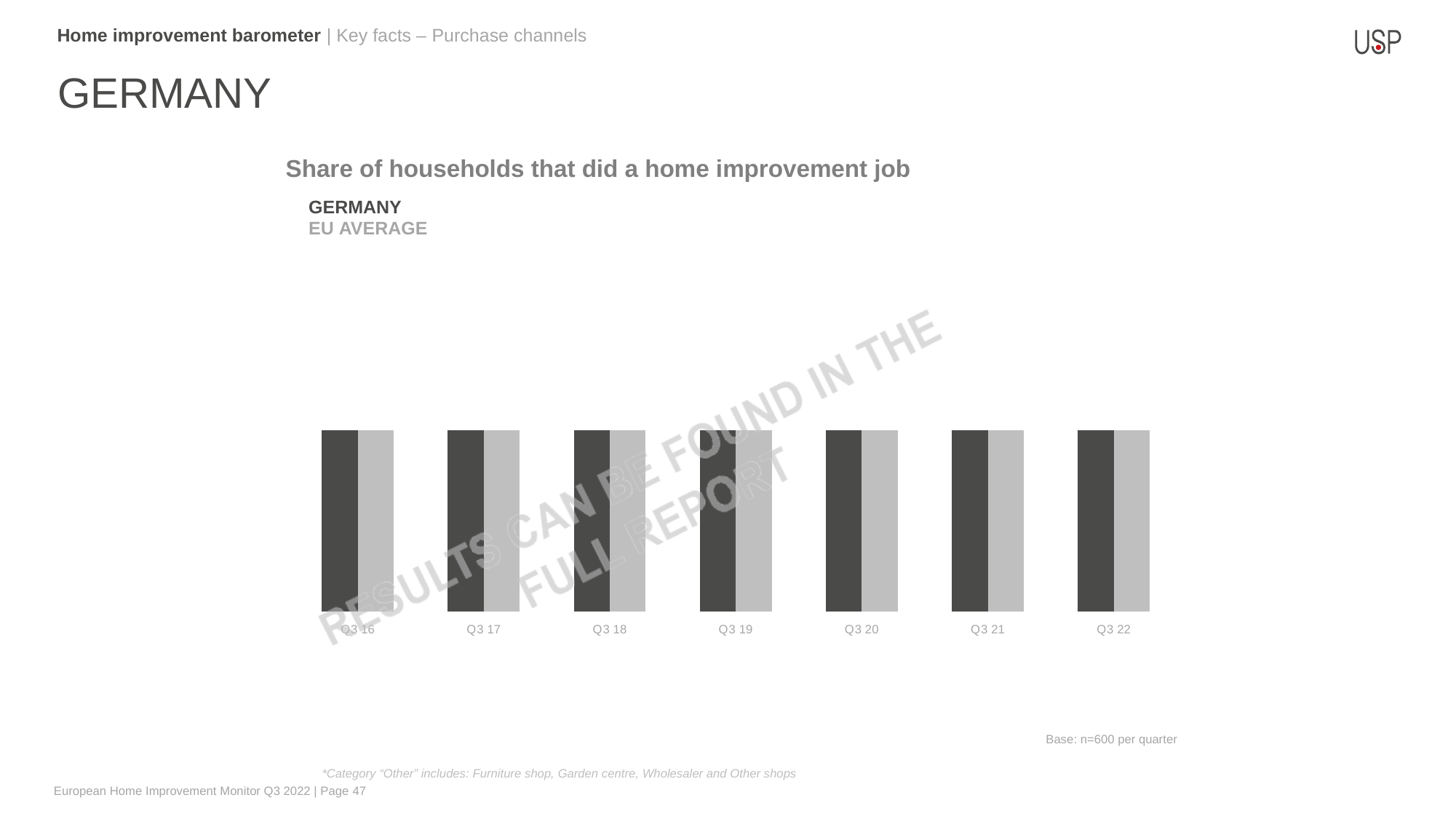
What is the title of the chart? Share of households that did a home improvement job What is the last category label on the x axis of the chart? Q3 22 What is the first category label on the x axis of the chart? Q3 16 Do the bar heights in the chart rise, fall, or stay flat from Q3 16 to Q3 22? Stay flat How many quarters (categories) are shown along the x axis of the chart? 7 Which two series are listed in the chart's legend? GERMANY and EU AVERAGE What kind of chart is shown on the slide? Bar chart How many series does the chart's legend list? 2